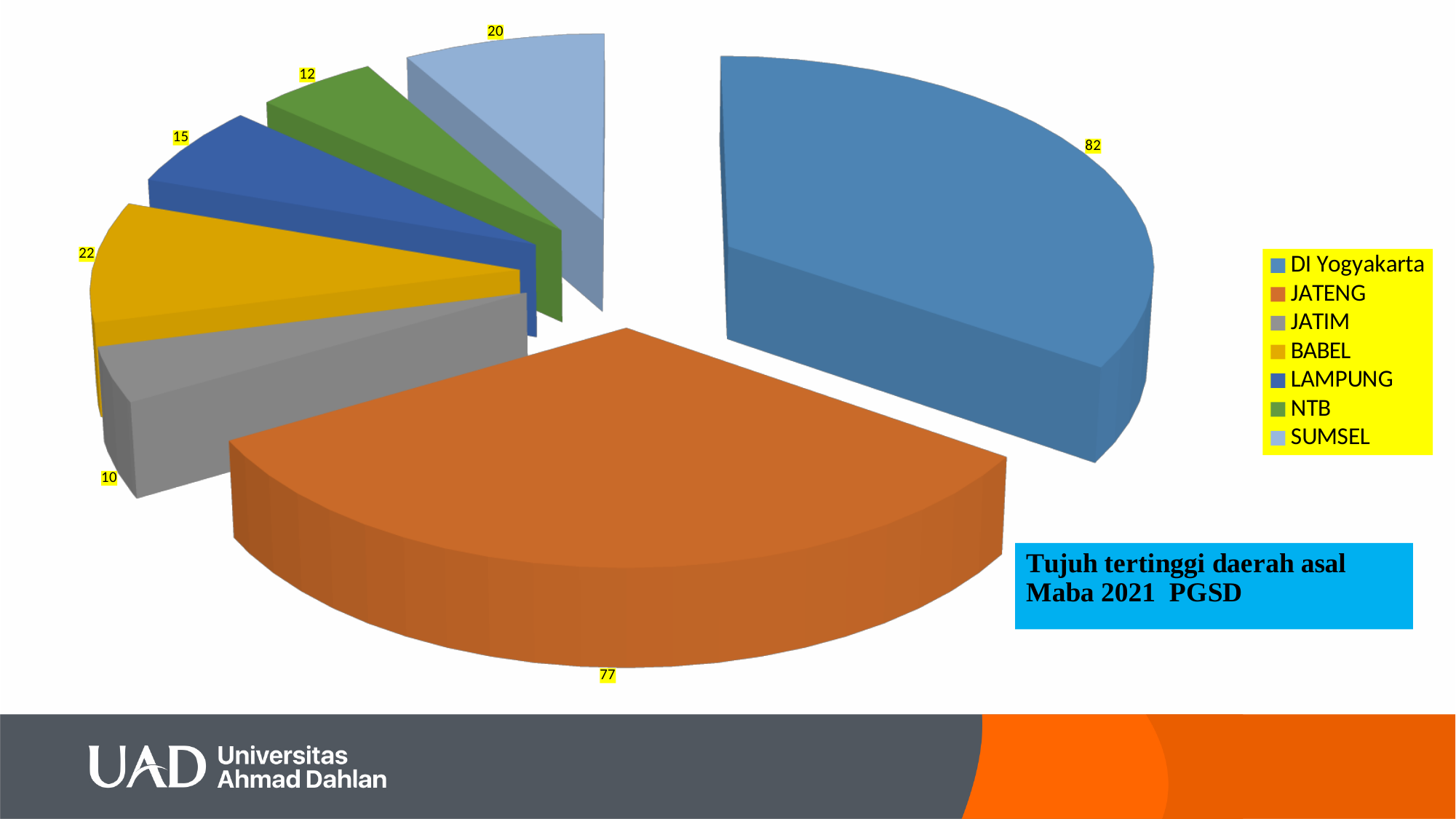
What is the value for BABEL? 22 What is the value for JATENG? 77 Which is larger, the value for LAMPUNG or the value for NTB? LAMPUNG What kind of chart is shown on the slide? Pie chart What is the value for DI Yogyakarta? 82 What is the value for SUMSEL? 20 What is the difference between the values for DI Yogyakarta and JATENG? 5 Which region has the largest slice? DI Yogyakarta How many entries does the legend list? 7 What is the text in the blue box next to the chart? Tujuh tertinggi daerah asal Maba 2021 PGSD How many slices does the pie chart have? 7 Which region has the smallest slice? JATIM